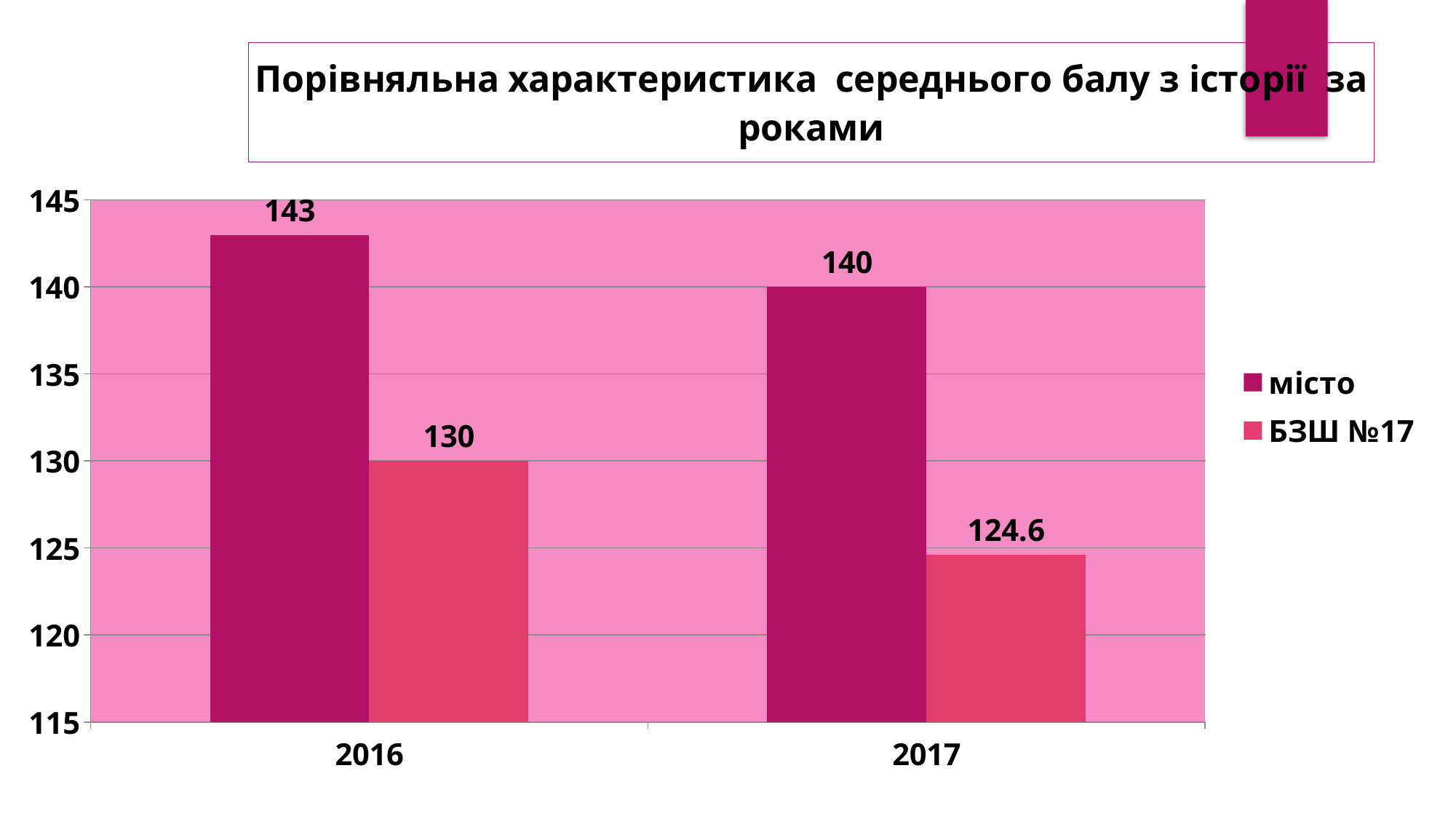
What is the value for БЗШ №17 in 2017? 124.6 Do the values for БЗШ №17 rise or fall from 2016 to 2017? fall What is the value for місто in 2016? 143 Which series has the highest value in 2016? місто Which is larger: БЗШ №17 in 2016 or БЗШ №17 in 2017? БЗШ №17 in 2016 What is the difference between місто and БЗШ №17 in 2017? 15.4 What is the value for місто in 2017? 140 Which bar has the lowest value on the chart? БЗШ №17 in 2017 How many series does the legend list? 2 What kind of chart is shown on the slide? bar chart What is the difference between the місто values for 2016 and 2017? 3 What is the value for БЗШ №17 in 2016? 130